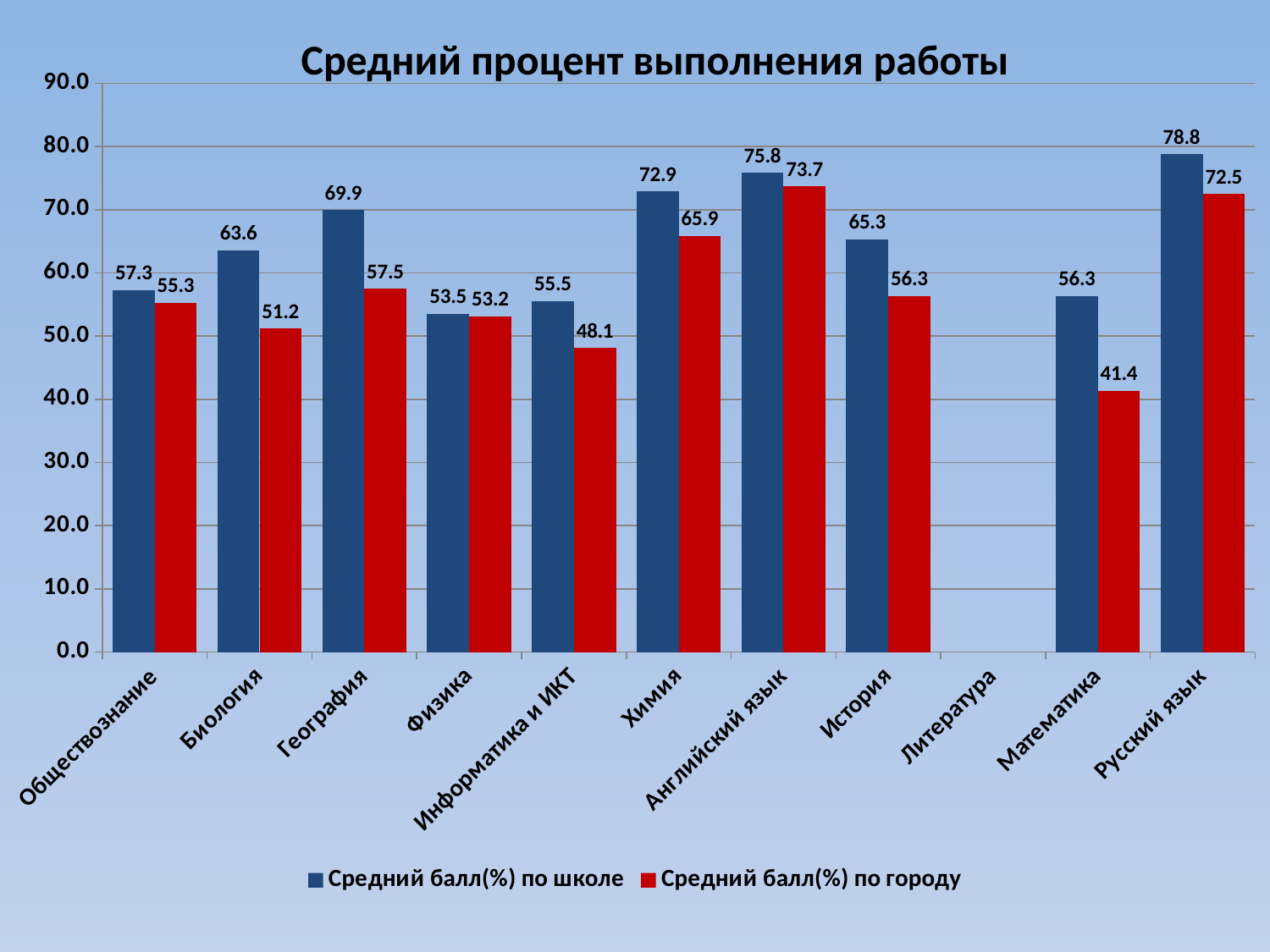
What is the value of 'Средний балл(%) по школе' for Химия? 72.9 What is the value of 'Средний балл(%) по городу' for Математика? 41.4 How many series does the legend list? 2 Which subject has the lowest value for 'Средний балл(%) по городу'? Математика What kind of chart is shown on the slide? Bar chart What is the title of the chart? Средний процент выполнения работы What is the value of 'Средний балл(%) по городу' for Информатика и ИКТ? 48.1 Is the value of 'Средний балл(%) по школе' for География greater or less than 60.0? greater Which is larger for Английский язык: 'Средний балл(%) по школе' or 'Средний балл(%) по городу'? Средний балл(%) по школе What is the difference between 'Средний балл(%) по школе' and 'Средний балл(%) по городу' for Биология? 12.4 How many subjects are listed on the x axis? 11 Which subject has the highest value for 'Средний балл(%) по школе'? Русский язык